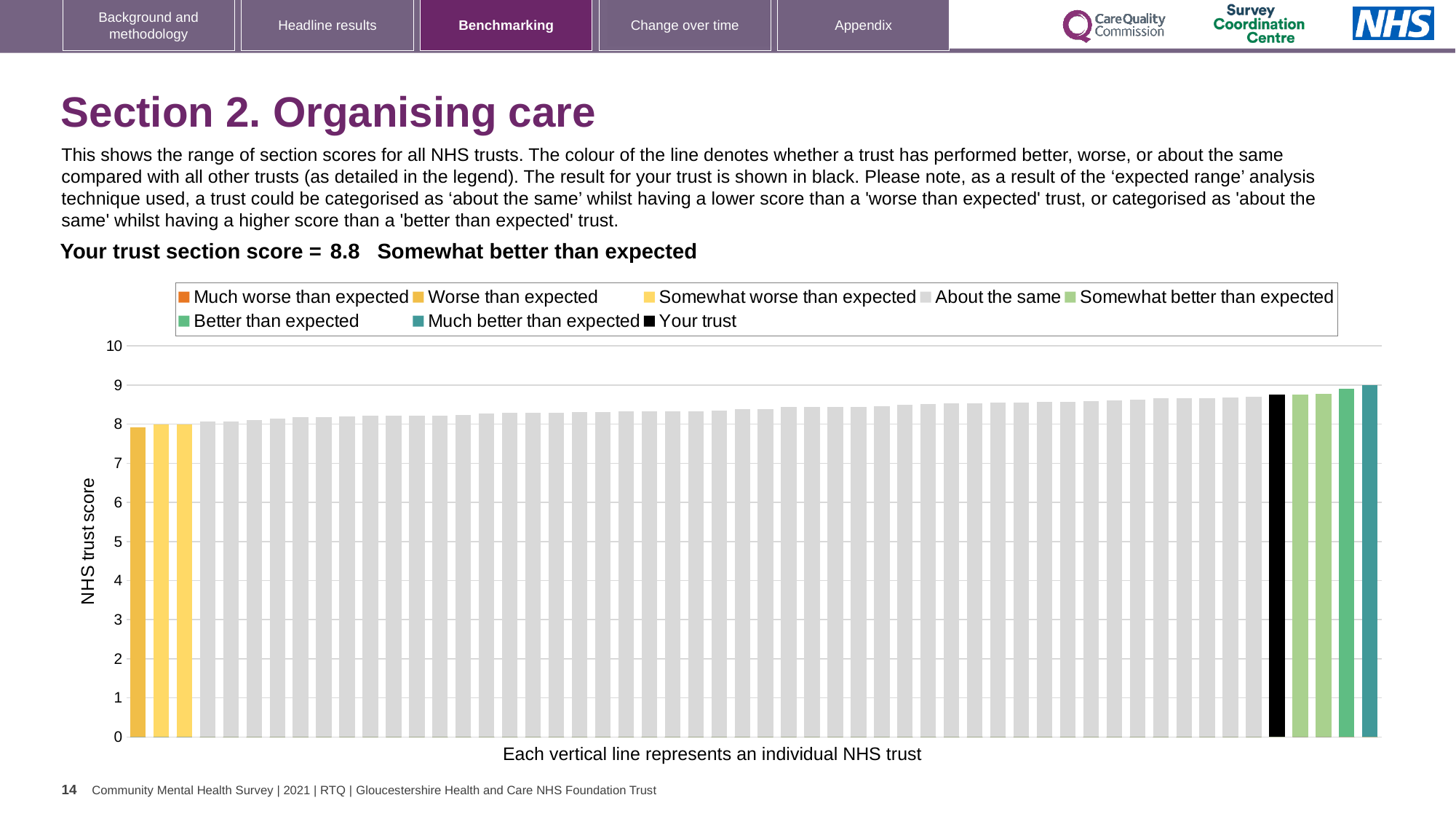
Is the value for your trust (the black bar) greater or less than 8? greater Which category does your trust fall into according to the slide? Somewhat better than expected Do the bar values rise or fall from left to right along the x axis? rise What kind of chart is shown on the slide? bar chart Which is larger: the value for your trust (black bar) or the value of the leftmost bar? your trust (black bar) What colour is used for the 'Your trust' bar in the chart? black What is the label on the vertical axis of the chart? NHS trust score How many bars are coloured as 'Worse than expected' (yellow) in the chart? 1 How many entries does the chart legend list? 8 What is the section score for your trust shown on the slide? 8.8 Is the value of the lowest bar in the chart greater or less than 7? greater How many bars are coloured as 'Much better than expected' (teal) in the chart? 1